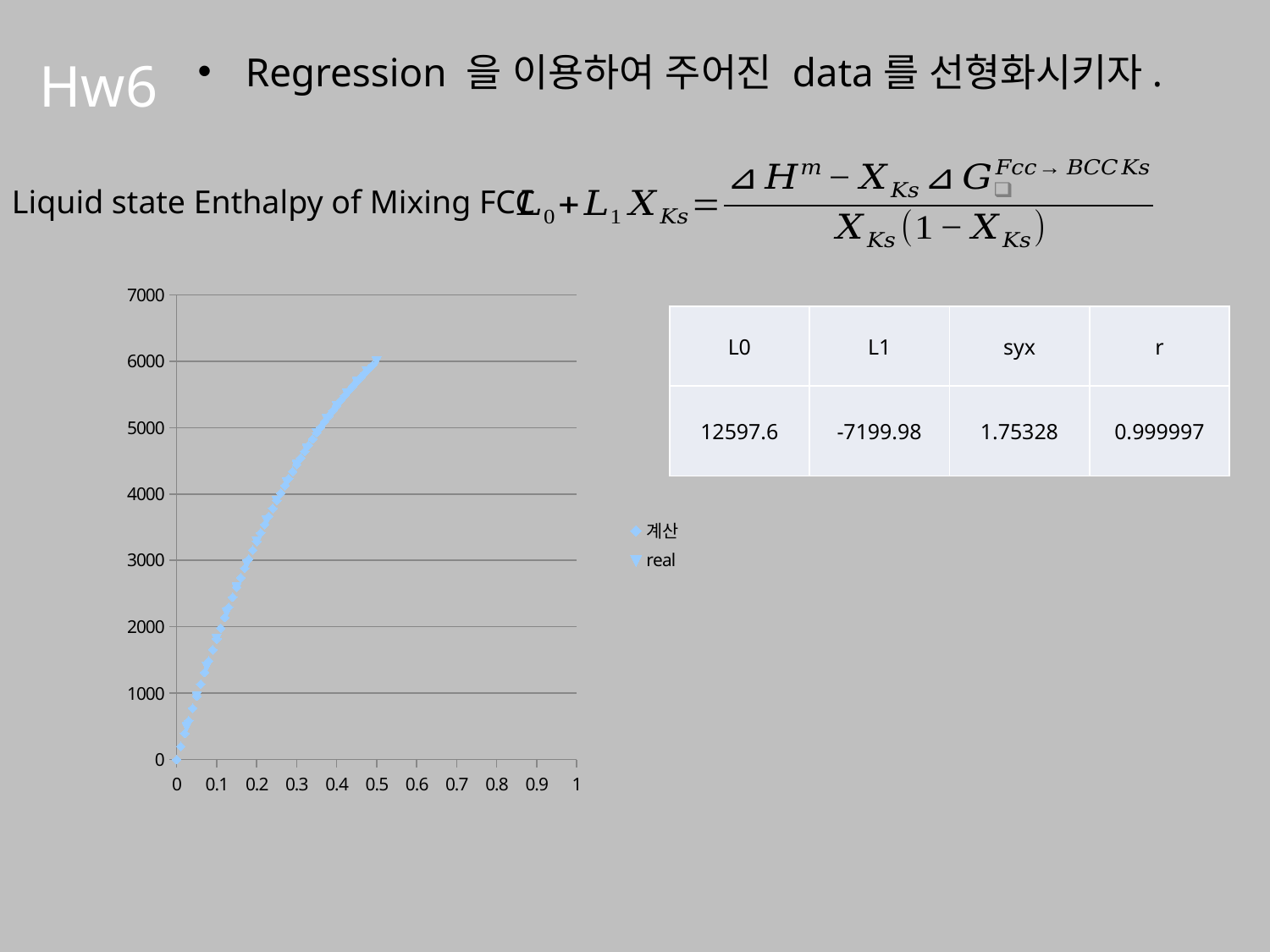
Is the plotted value at x = 0.2 greater or less than 3000? greater What is the maximum value shown on the chart's x axis? 1 What kind of chart is shown on the slide? scatter chart How many series does the chart legend list? 2 Is the plotted value at x = 0.4 greater or less than 5000? greater Is the largest x value at which data points are plotted greater or less than 0.6? less Do the plotted values rise or fall as the x value increases from 0 to 0.5? rise What are the two series names shown in the chart legend? 계산 and real What is the maximum value shown on the chart's y axis? 7000